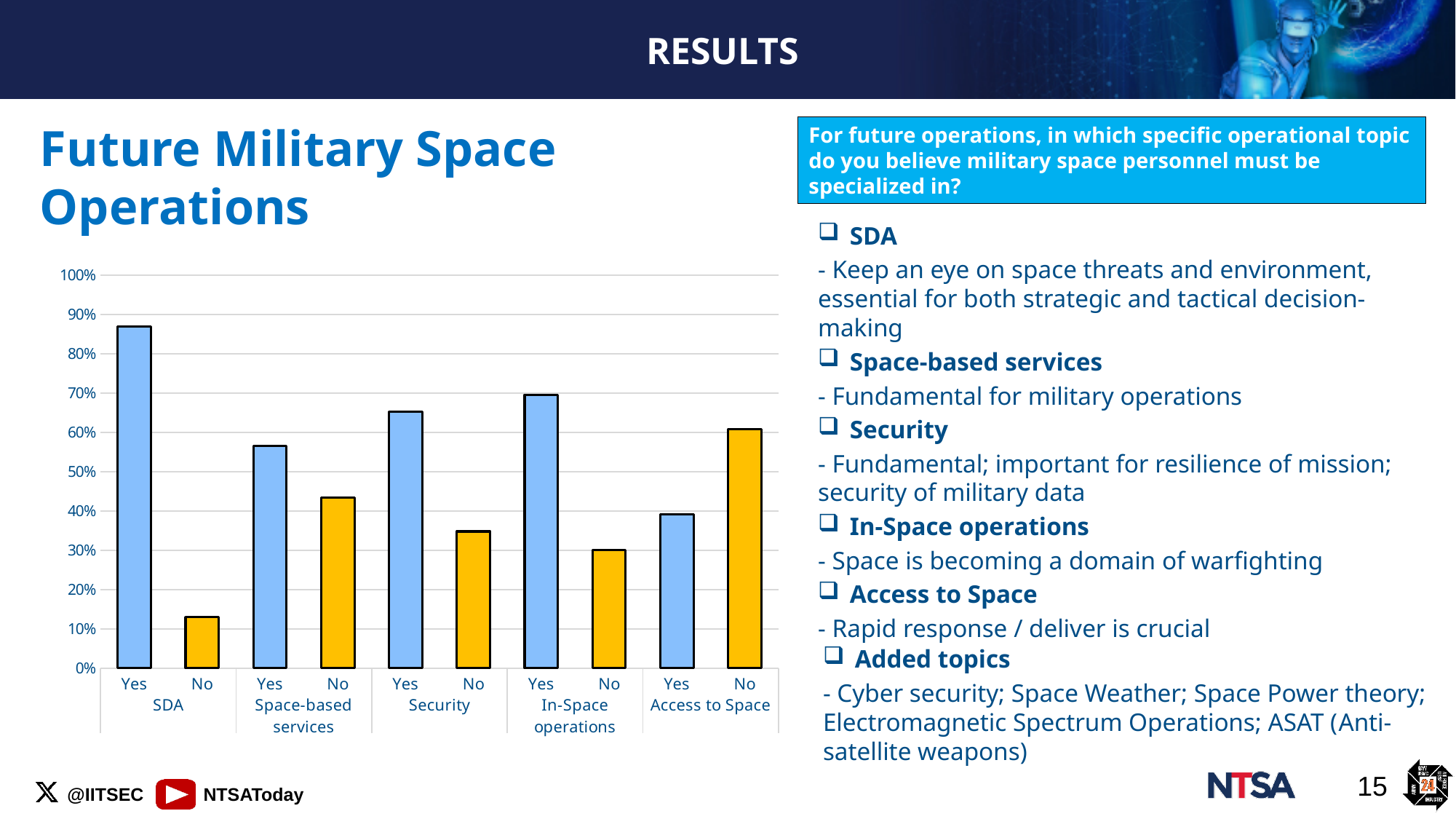
What colour are the No bars in the chart? yellow Is the value for Yes under In-Space operations greater or less than 60%? greater For Access to Space, which is larger, the Yes bar or the No bar? No How many bars are plotted in the chart? 10 Is the value for No under Access to Space greater or less than 50%? greater How many topic groups are shown along the x axis of the chart? 5 Is the value for Yes under SDA greater or less than 80%? greater Which bar in the chart is the lowest? No, SDA For Security, which is larger, the Yes bar or the No bar? Yes Which bar in the chart is the highest? Yes, SDA What kind of chart is shown on the slide? bar chart